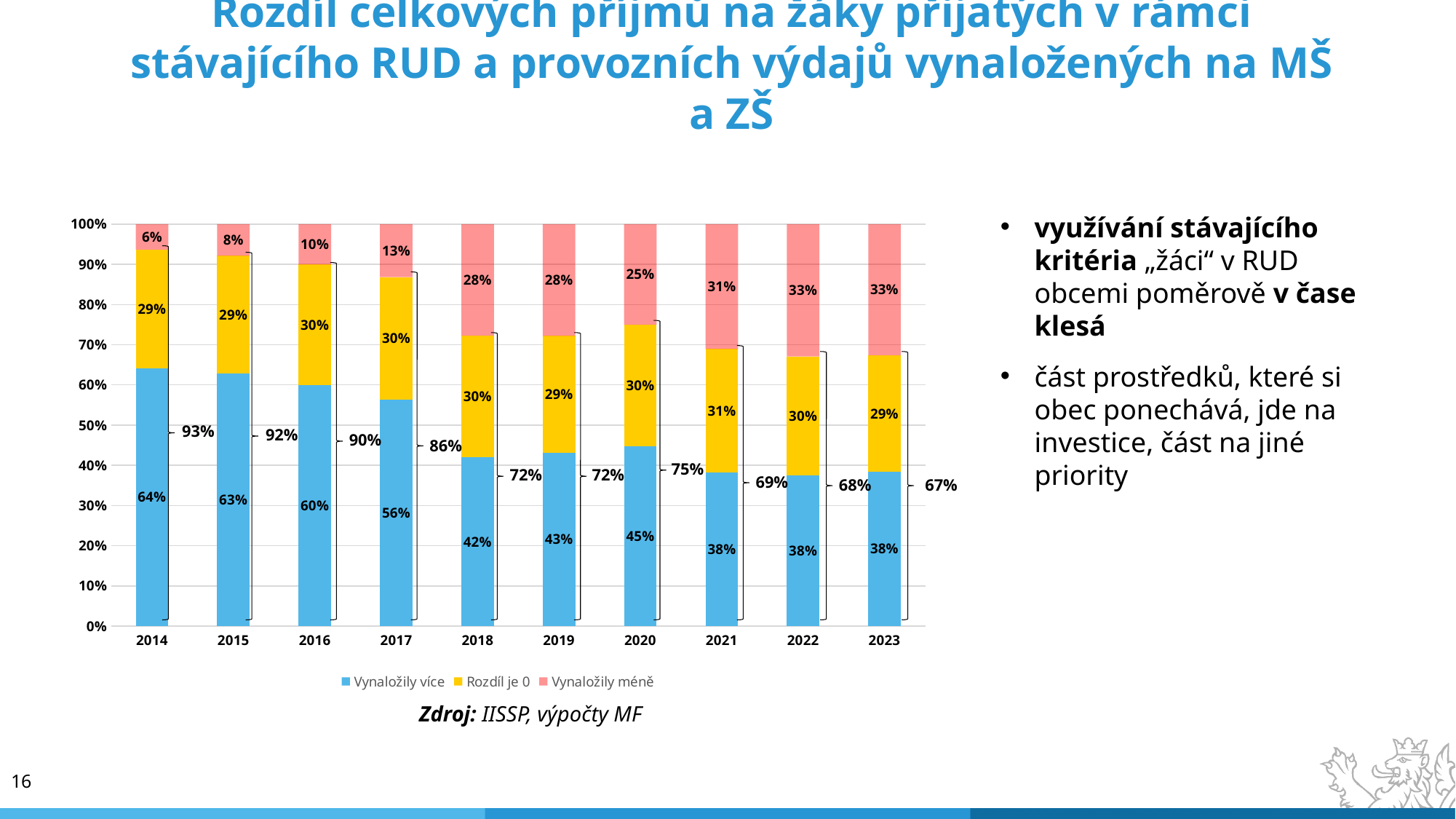
In which year is the 'Vynaložily méně' share the lowest? 2014 Which is larger: the 'Vynaložily méně' value for 2017 or for 2020? 2020 What type of chart is shown on the slide? stacked bar chart What is the difference between the 'Vynaložily více' values for 2014 and 2023? 26 percentage points What is the value of 'Vynaložily více' for 2014? 64% Does the 'Vynaložily více' share rise or fall from 2014 to 2023? fall How many years are shown on the x axis? 10 What is the combined share of 'Vynaložily více' and 'Rozdíl je 0' shown by the bracket for 2021? 69% What is the value of 'Rozdíl je 0' for 2018? 30% In which year is the 'Vynaložily více' share the highest? 2014 What is the value of 'Vynaložily méně' for 2023? 33% How many series does the legend list? 3